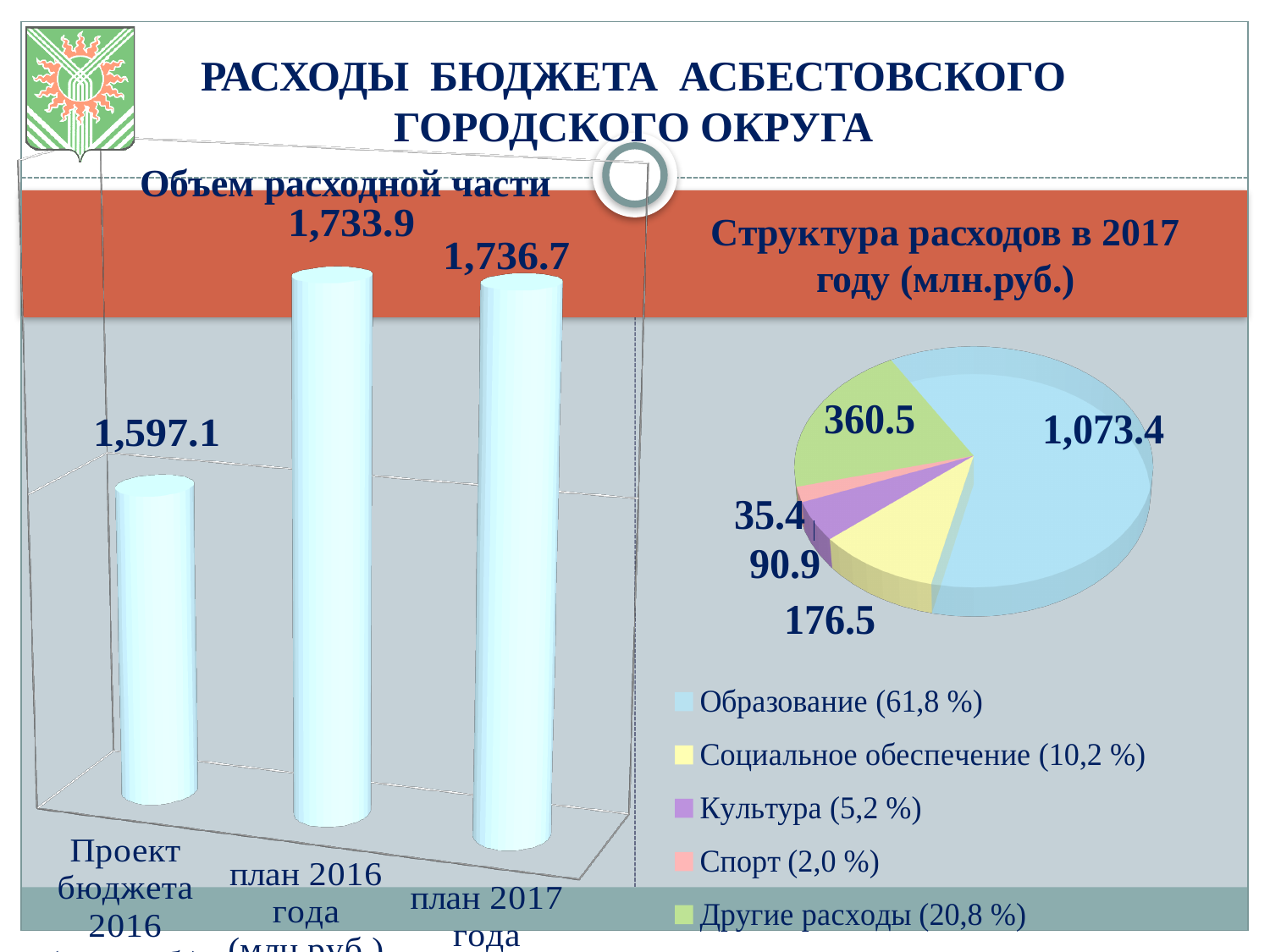
On the pie chart "Структура расходов в 2017 году (млн.руб.)", what share does "Другие расходы" have? 20,8 % On the bar chart "Объем расходной части", which category has the lowest value? Проект бюджета 2016 On the bar chart "Объем расходной части", what is the value for "план 2017 года"? 1,736.7 What kind of chart is "Объем расходной части"? Bar chart On the bar chart "Объем расходной части", what is the value for "Проект бюджета 2016"? 1,597.1 On the pie chart "Структура расходов в 2017 году (млн.руб.)", which is larger: "Социальное обеспечение" or "Культура"? Социальное обеспечение On the bar chart "Объем расходной части", do the values rise or fall from left to right? Rise On the bar chart "Объем расходной части", how many bars are shown? 3 How many entries does the legend of the pie chart "Структура расходов в 2017 году (млн.руб.)" list? 5 On the bar chart "Объем расходной части", what is the difference between "план 2016 года" and "Проект бюджета 2016"? 136.8 On the pie chart "Структура расходов в 2017 году (млн.руб.)", what is the value for "Спорт"? 35.4 On the pie chart "Структура расходов в 2017 году (млн.руб.)", what is the value for "Образование"? 1,073.4